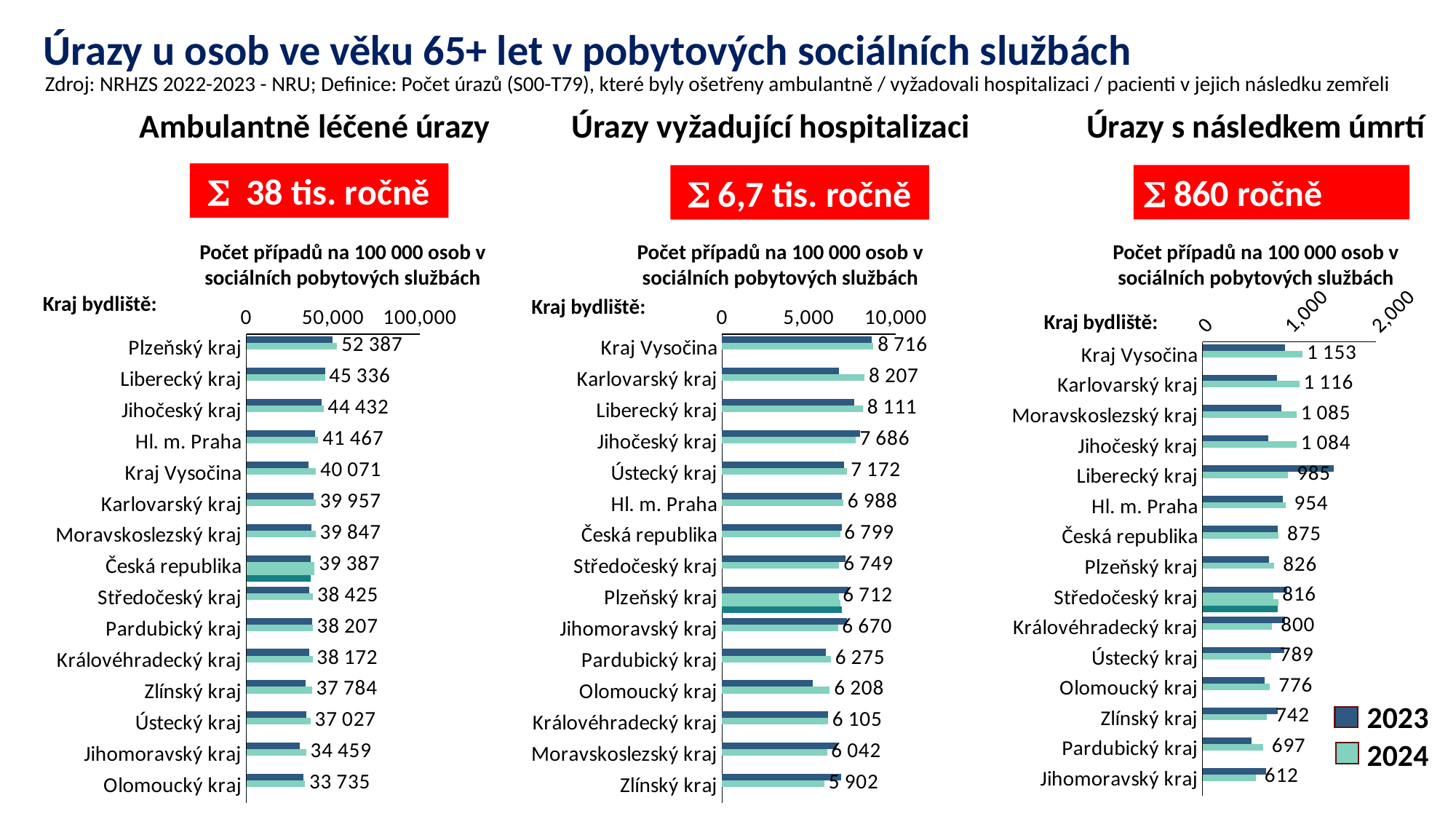
How many regions (categories) are shown in the chart 'Ambulantně léčené úrazy'? 15 In the chart 'Úrazy s následkem úmrtí', what is the 2024 value for Hl. m. Praha? 954 In the chart 'Úrazy vyžadující hospitalizaci', which region has the highest labelled 2024 value? Kraj Vysočina What kind of chart is 'Úrazy s následkem úmrtí'? bar chart In the chart 'Úrazy vyžadující hospitalizaci', what is the 2024 value for Česká republika? 6 799 How many series does the legend on the slide list? 2 In the chart 'Úrazy vyžadující hospitalizaci', what is the difference between the 2024 values for Kraj Vysočina and Zlínský kraj? 2 814 In the chart 'Úrazy s následkem úmrtí', what is the difference between the 2024 values for Kraj Vysočina and Jihomoravský kraj? 541 In the chart 'Úrazy s následkem úmrtí', is the 2023 value for Liberecký kraj greater or less than 1,000? greater In the chart 'Ambulantně léčené úrazy', which region has the lowest labelled 2024 value? Olomoucký kraj In the chart 'Ambulantně léčené úrazy', what is the 2024 value for Plzeňský kraj? 52 387 In the chart 'Úrazy s následkem úmrtí', which has the larger 2024 value: Hl. m. Praha or Plzeňský kraj? Hl. m. Praha